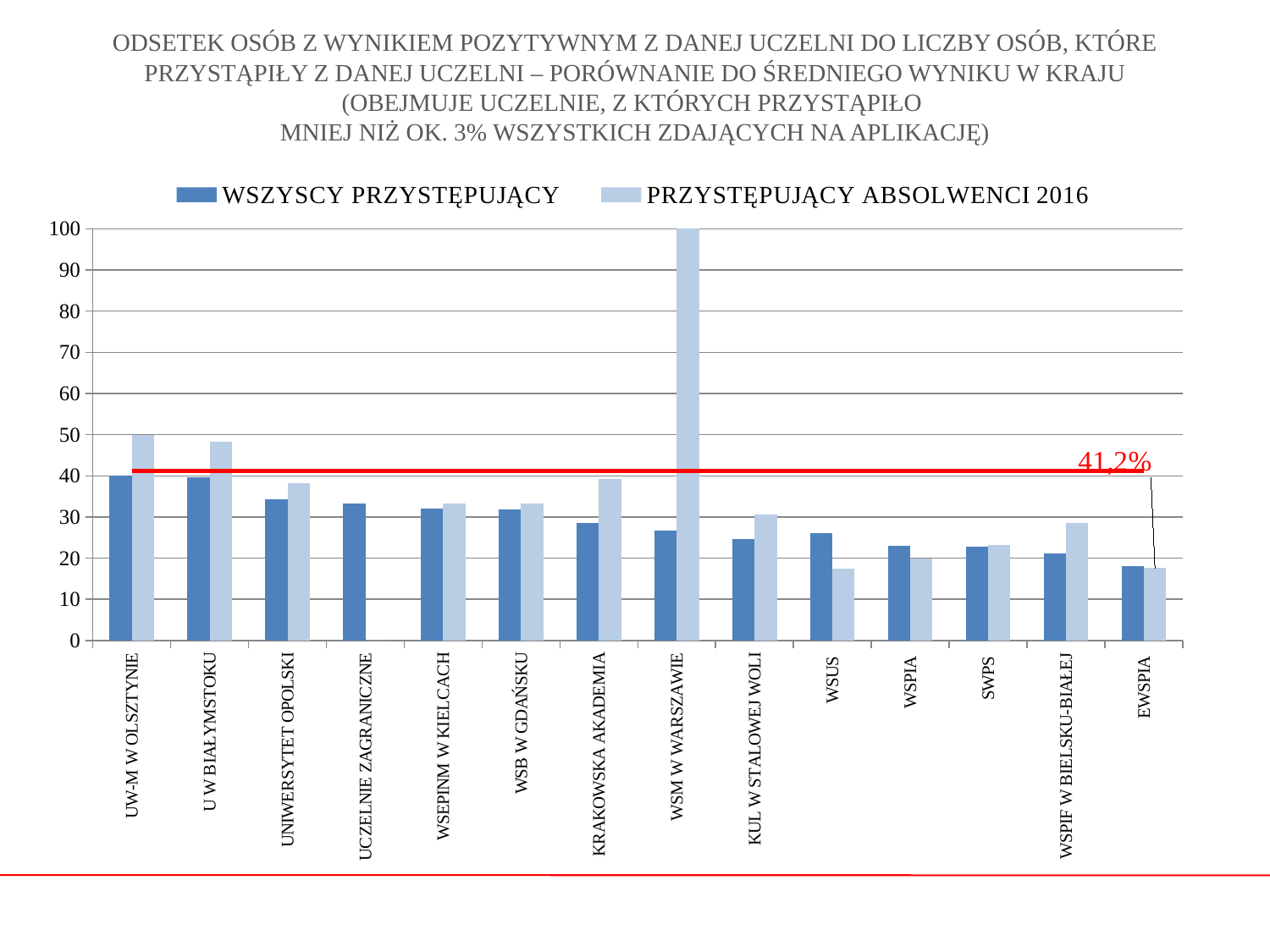
What is the value for PRZYSTĘPUJĄCY ABSOLWENCI 2016 at WSM W WARSZAWIE? 100 Which university has the lowest value for WSZYSCY PRZYSTĘPUJĄCY? EWSPIA Is the value for WSZYSCY PRZYSTĘPUJĄCY at UNIWERSYTET OPOLSKI greater or less than 30? greater How many series does the legend list? 2 What value is marked by the red horizontal line on the chart? 41,2% Which university has the highest value for PRZYSTĘPUJĄCY ABSOLWENCI 2016? WSM W WARSZAWIE How many universities (categories) are shown on the x axis? 14 Which university has only one bar (no PRZYSTĘPUJĄCY ABSOLWENCI 2016 bar) on the chart? UCZELNIE ZAGRANICZNE Is the value for PRZYSTĘPUJĄCY ABSOLWENCI 2016 at WSUS greater or less than 20? less At WSUS, which series has the larger value: WSZYSCY PRZYSTĘPUJĄCY or PRZYSTĘPUJĄCY ABSOLWENCI 2016? WSZYSCY PRZYSTĘPUJĄCY What kind of chart is shown on the slide? bar chart